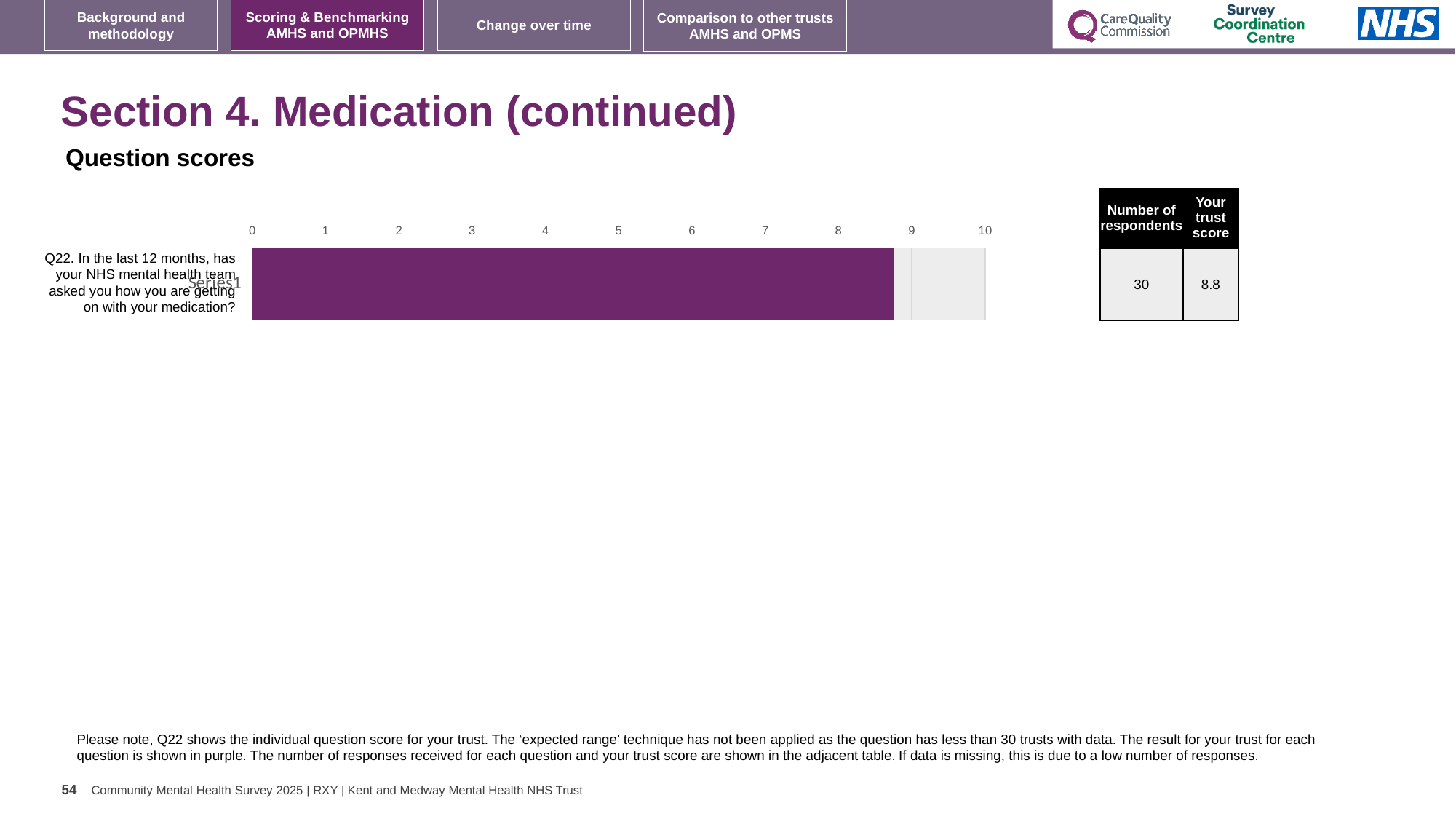
What colour is the bar for Q22? purple Is the value for Q22 greater or less than 5? greater How many questions (categories) are plotted in the chart? 1 According to the adjacent table, how many respondents answered Q22? 30 Is the value for Q22 greater or less than 8? greater What kind of chart is shown on the slide? bar chart What is the highest value shown on the chart's horizontal axis? 10 Is the value for Q22 greater or less than 9? less According to the adjacent table, what is the trust score for Q22? 8.8